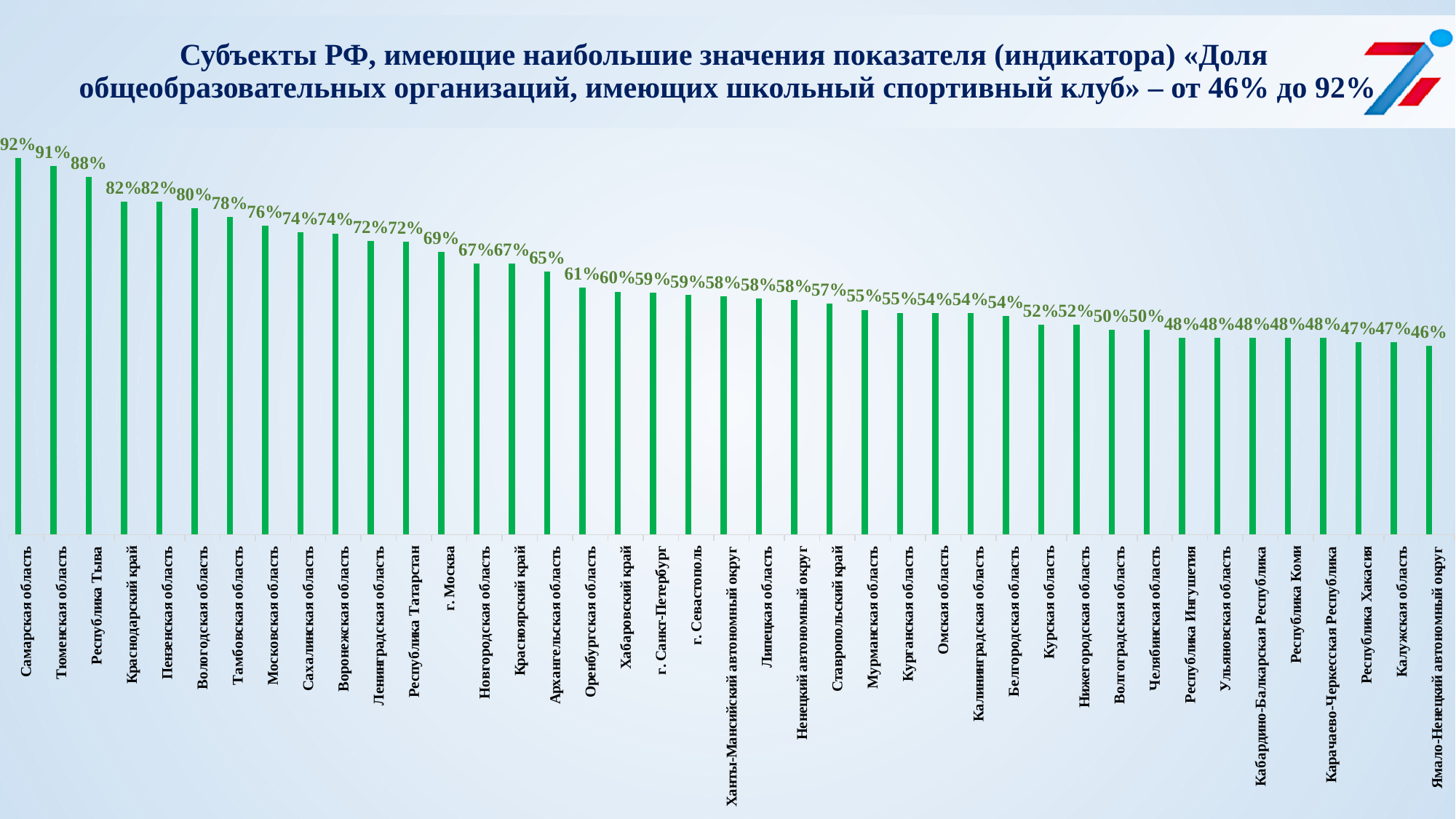
How many regions are shown on the chart? 41 Which region has the lowest value on the chart? Ямало-Ненецкий автономный округ What kind of chart is shown on the slide? Bar chart What is the value for г. Москва? 69% What is the value for Самарская область? 92% Which has a larger value, Оренбургская область or Хабаровский край? Оренбургская область What is the value for Ставропольский край? 57% What is the difference between the values for Республика Тыва and Московская область? 12% What is the value for Ямало-Ненецкий автономный округ? 46% Do the values rise or fall from left to right along the x axis? Fall What colour are the bars on the chart? Green Which region has the highest value on the chart? Самарская область